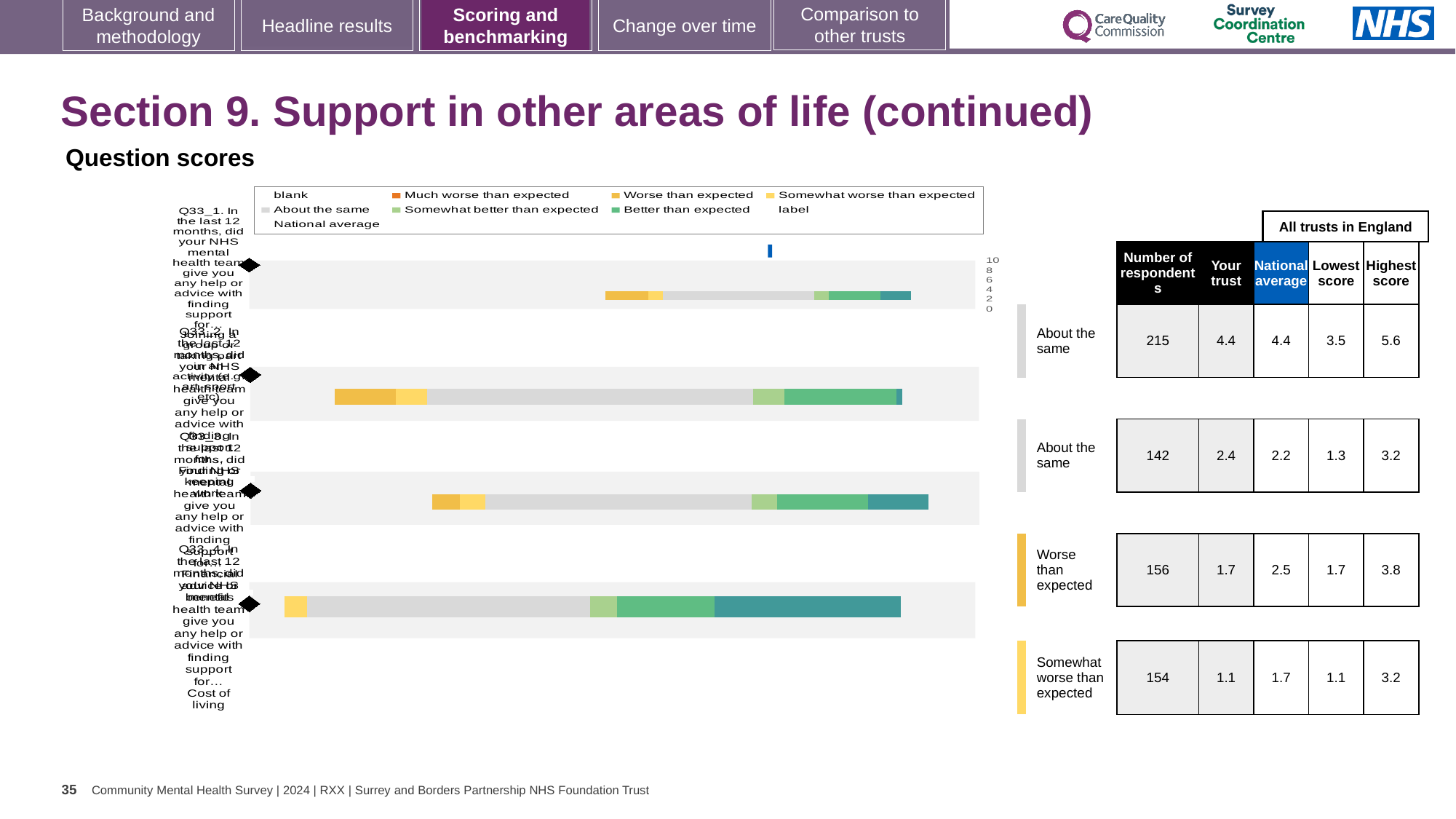
What colour does the legend use for 'Worse than expected'? orange/yellow For Q33_2, which is larger: the 'Your trust' score or the national average? Your trust Which question has the lowest 'Your trust' score in the table beside the chart? Q33_4 How many question bars (Q33_1 to Q33_4) are plotted in the chart? 4 In the table beside the chart, how many respondents are listed for Q33_1? 215 In the table beside the chart, what is the national average for Q33_4? 1.7 What kind of chart is shown on the slide? bar chart What benchmark category is shown for Q33_3 next to the chart? Worse than expected Which question has the highest number of respondents in the table beside the chart? Q33_1 What is the difference between the national average and the 'Your trust' score for Q33_3? 0.8 What is the highest score across all trusts in England for Q33_1? 5.6 In the table beside the chart, what is the 'Your trust' score for Q33_3? 1.7